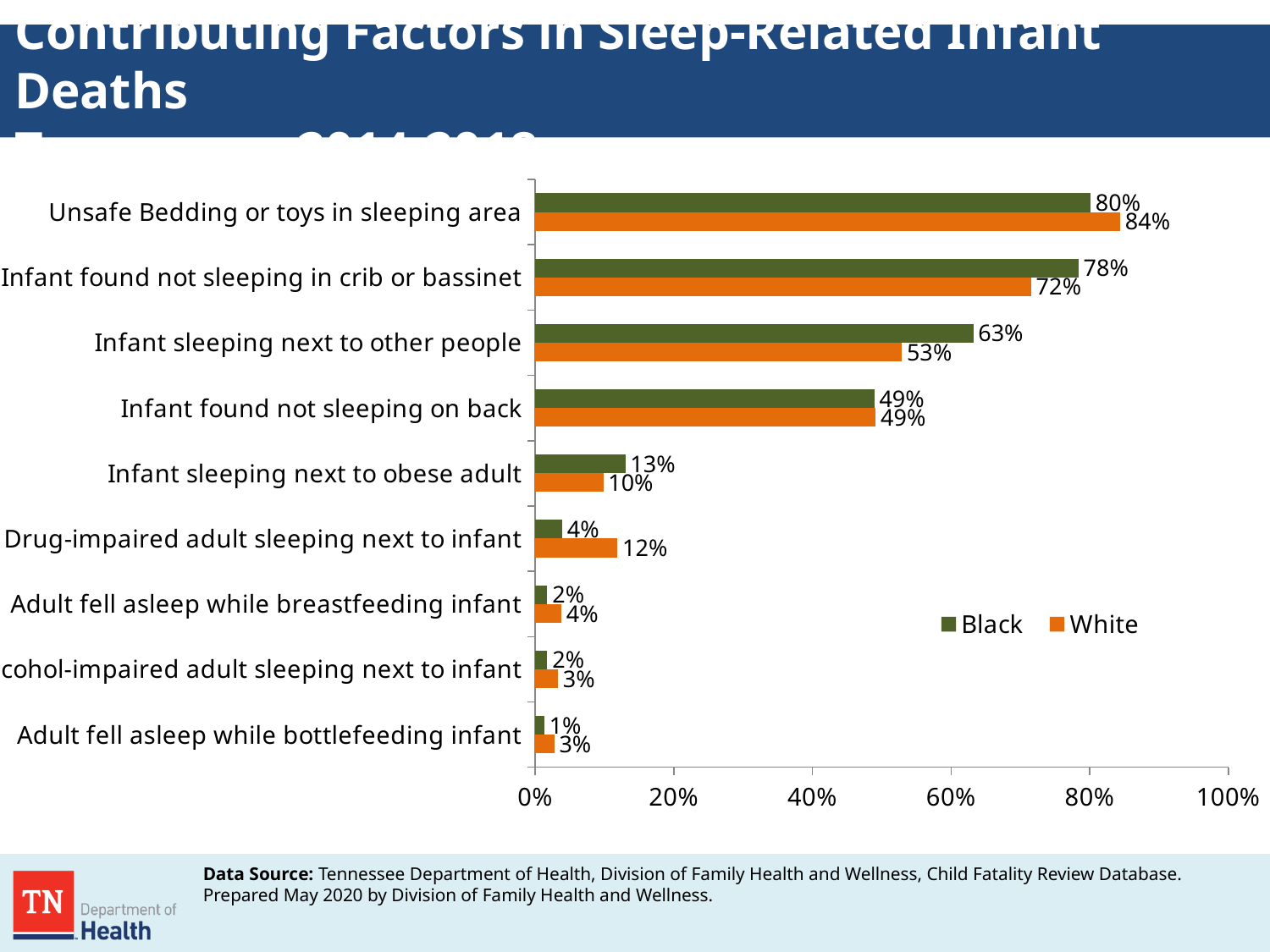
What kind of chart is shown on the slide? Bar chart Which colour represents the White series in the chart? Orange Which category has the lowest Black value? Adult fell asleep while bottlefeeding infant Which category has the highest Black value? Unsafe Bedding or toys in sleeping area How many categories are shown on the chart? 9 What is the difference between the Black and White values for 'Infant sleeping next to other people'? 10% What is the White value for 'Unsafe Bedding or toys in sleeping area'? 84% What is the Black value for 'Infant found not sleeping on back'? 49% What is the Black value for 'Infant found not sleeping in crib or bassinet'? 78% What is the White value for 'Drug-impaired adult sleeping next to infant'? 12% How many series does the legend list? 2 For 'Drug-impaired adult sleeping next to infant', which series has the larger value, Black or White? White